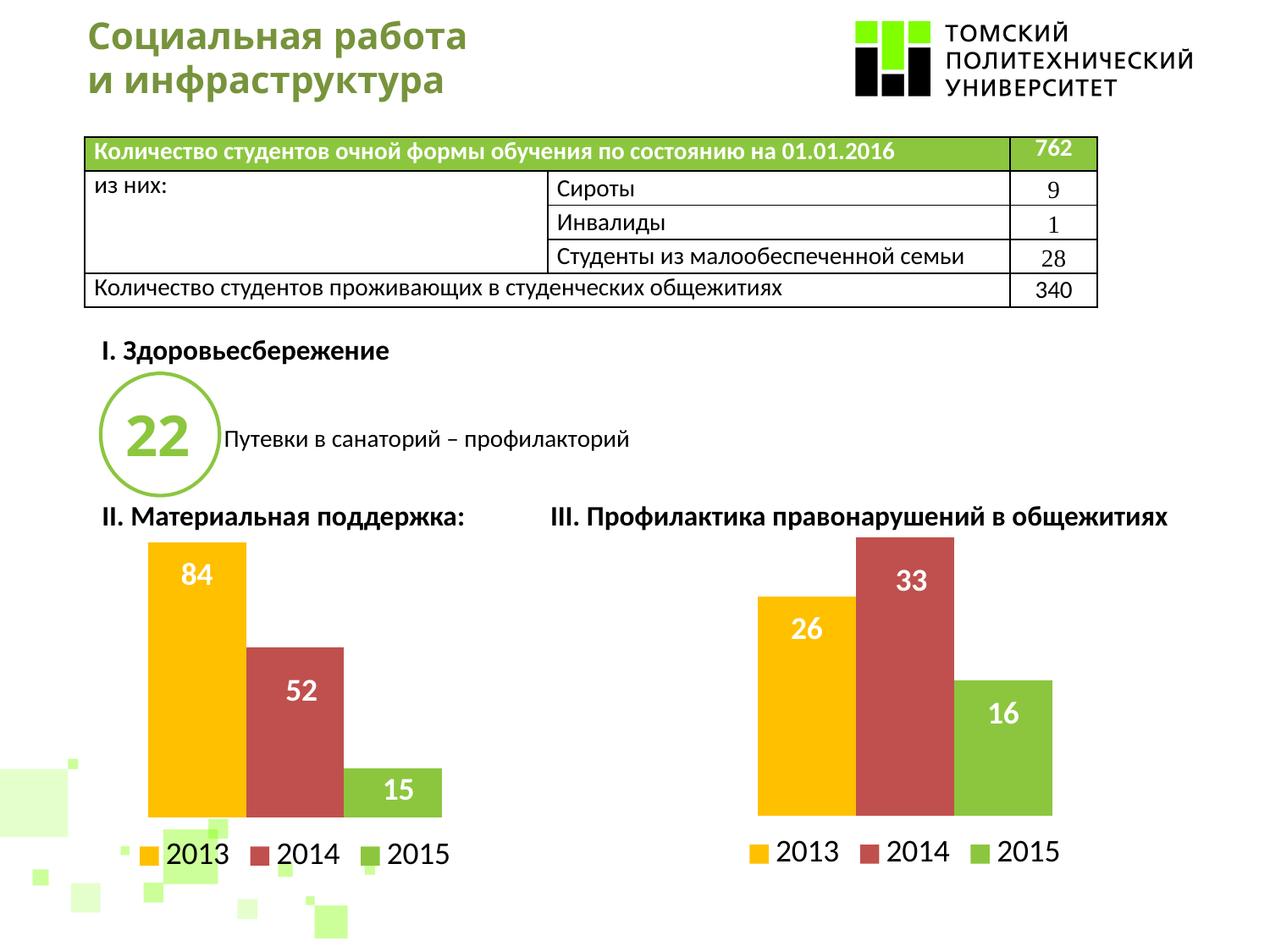
In the chart under 'II. Материальная поддержка', what is the difference between the 2013 and 2014 values? 32 In the chart under 'II. Материальная поддержка', do the values rise or fall from 2013 to 2015? fall In the chart under 'III. Профилактика правонарушений в общежитиях', what is the value for 2014? 33 What kind of chart is shown under 'III. Профилактика правонарушений в общежитиях'? bar chart In the chart under 'II. Материальная поддержка', which year has the highest value? 2013 In the chart under 'II. Материальная поддержка', what is the value for 2015? 15 In the chart under 'II. Материальная поддержка', what is the value for 2013? 84 How many entries does the legend of the chart under 'II. Материальная поддержка' list? 3 In the chart under 'III. Профилактика правонарушений в общежитиях', which is larger, the value for 2013 or 2015? 2013 In the chart under 'III. Профилактика правонарушений в общежитиях', what is the value for 2013? 26 In the chart under 'III. Профилактика правонарушений в общежитиях', what is the difference between the 2014 and 2015 values? 17 In the chart under 'III. Профилактика правонарушений в общежитиях', which year has the lowest value? 2015